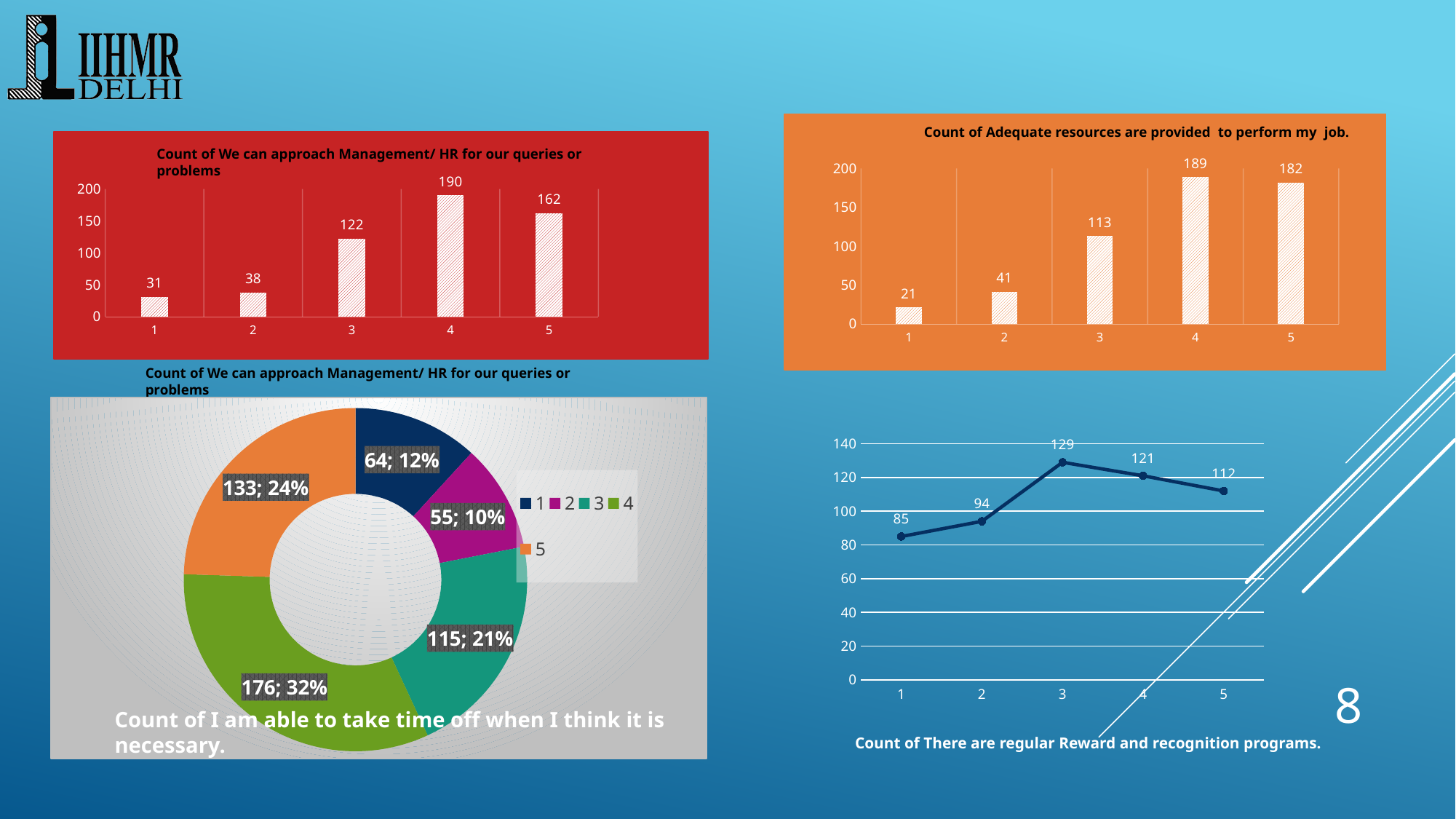
In the top-right bar chart, is the value for category 2 larger or smaller than the value for category 1? larger How many series does the legend of the bottom-left doughnut chart list? 5 In the top-left bar chart, which category has the lowest value? 1 In the top-left bar chart titled 'Count of We can approach Management/ HR for our queries or problems', what is the value for category 4? 190 In the bottom-left doughnut chart, what is the count shown for slice 5? 133 In the top-right bar chart, which category has the highest value? 4 What kind of chart is the bottom-right chart titled 'Count of There are regular Reward and recognition programs.'? line chart In the top-right bar chart titled 'Count of Adequate resources are provided to perform my job.', what is the value for category 3? 113 In the bottom-right line chart, what is the value at point 3? 129 In the bottom-right line chart, do the values rise or fall from point 3 to point 5? fall In the bottom-left doughnut chart, what share of the total does slice 4 represent? 32% In the top-left bar chart, what is the difference between the values for categories 4 and 5? 28